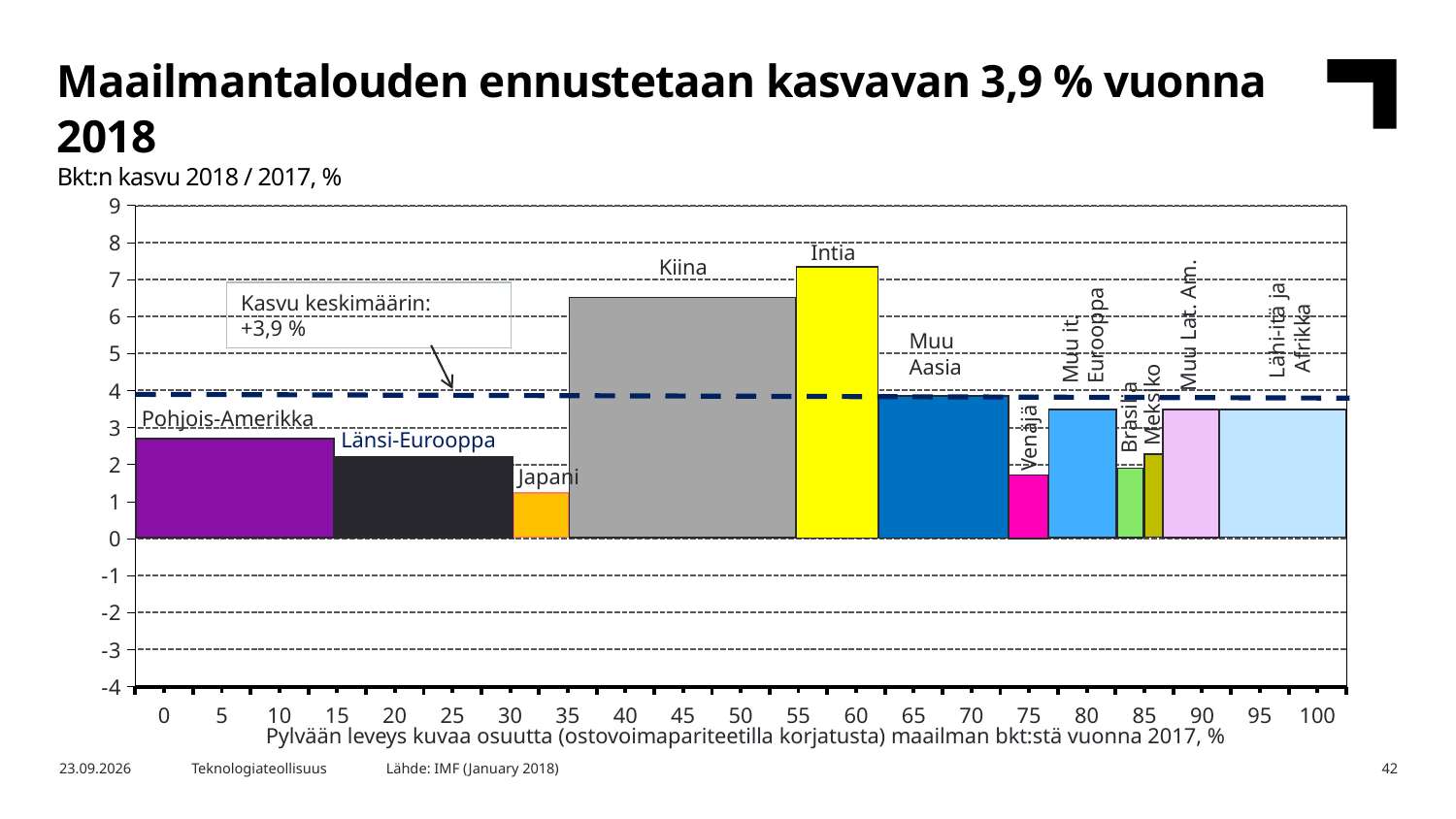
Which has the higher value, Kiina or Intia? Intia What kind of chart is shown on the slide? bar chart How many regions are plotted as bars in the chart? 12 Which region has the lowest GDP growth in the chart? Japani Is the value for Venäjä greater or less than 2? less Which region has the highest GDP growth in the chart? Intia What average growth (Kasvu keskimäärin) is stated in the chart annotation? +3,9 % What is the subtitle of the chart, shown above the plot area? Bkt:n kasvu 2018 / 2017, % Is the value for Japani greater or less than 2? less Which has the higher value, Pohjois-Amerikka or Länsi-Eurooppa? Pohjois-Amerikka Is the value for Kiina greater or less than 6? greater